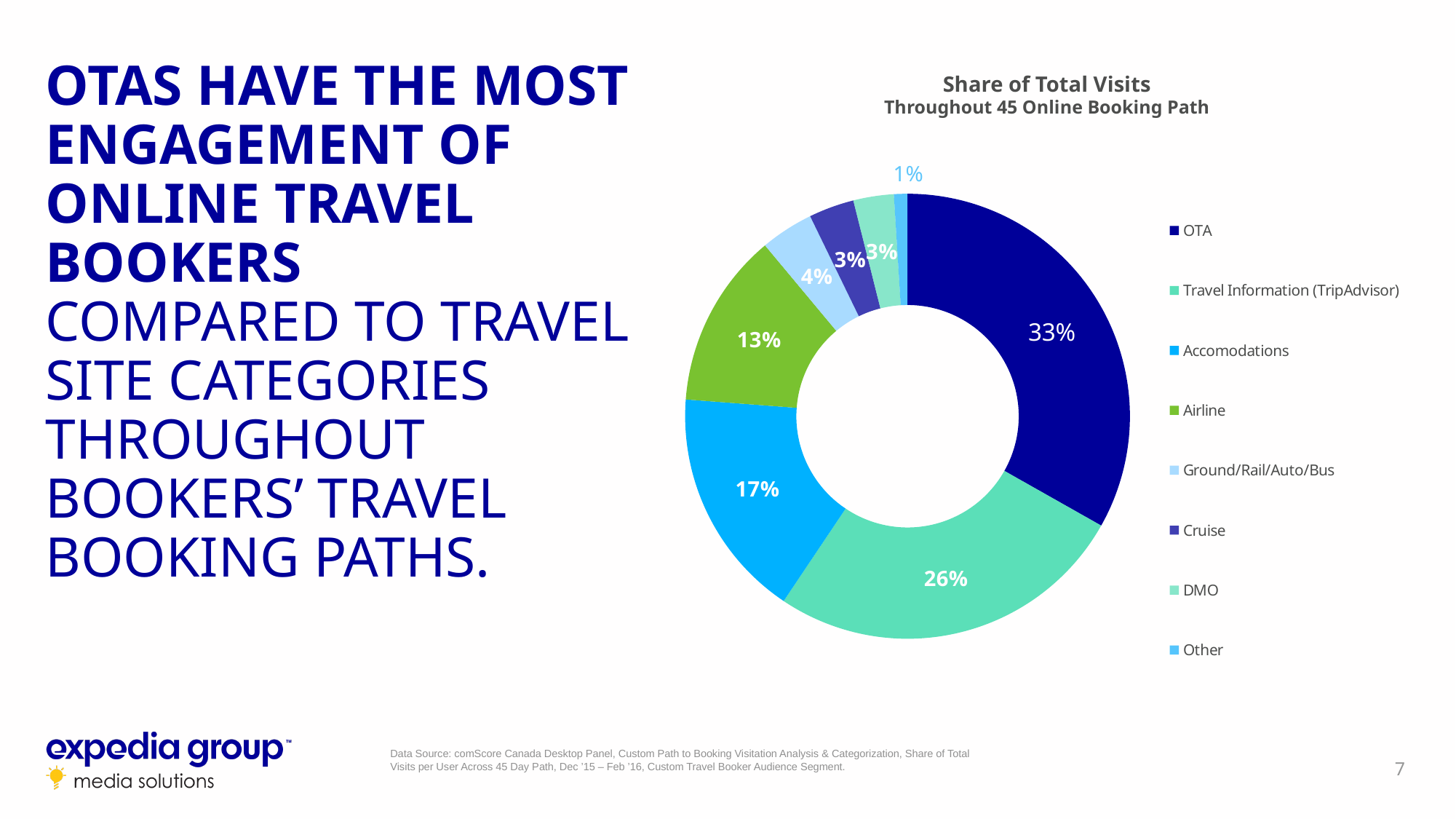
What is the value for Accomodations? 17% What is the value for Airline? 13% How many categories does the legend list? 8 What is the title of the chart? Share of Total Visits Throughout 45 Online Booking Path What is the value for Ground/Rail/Auto/Bus? 4% What share of total visits does OTA account for? 33% How many percentage points larger is the OTA share than the Travel Information (TripAdvisor) share? 7 percentage points Which is larger, the share for Accomodations or the share for Airline? Accomodations What kind of chart is shown on the slide? Doughnut chart What is the value for Travel Information (TripAdvisor)? 26% Which category has the smallest share of total visits? Other Which category has the largest share of total visits? OTA